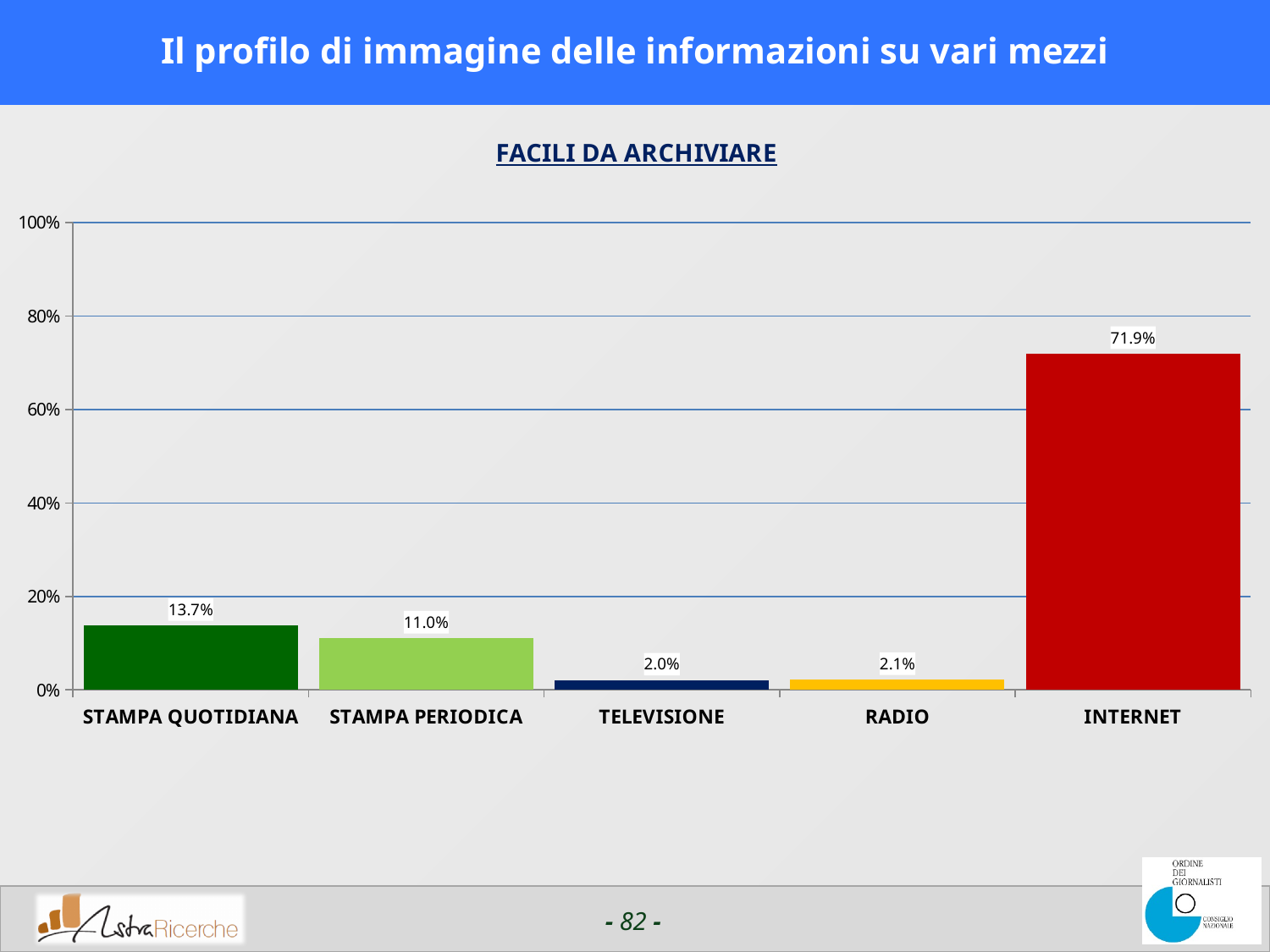
What is the value for STAMPA QUOTIDIANA? 13.7% Which category has the lowest value? TELEVISIONE What is the difference between the values for INTERNET and STAMPA QUOTIDIANA? 58.2% Which category has the highest value? INTERNET What is the value for INTERNET? 71.9% Which is larger, the value for STAMPA PERIODICA or the value for RADIO? STAMPA PERIODICA Is the value for INTERNET greater or less than 60%? greater How many categories are shown on the x axis? 5 What is the difference between the values for STAMPA QUOTIDIANA and STAMPA PERIODICA? 2.7% What is the value for TELEVISIONE? 2.0% What kind of chart is shown on the slide? bar chart What is the title shown above the chart? FACILI DA ARCHIVIARE